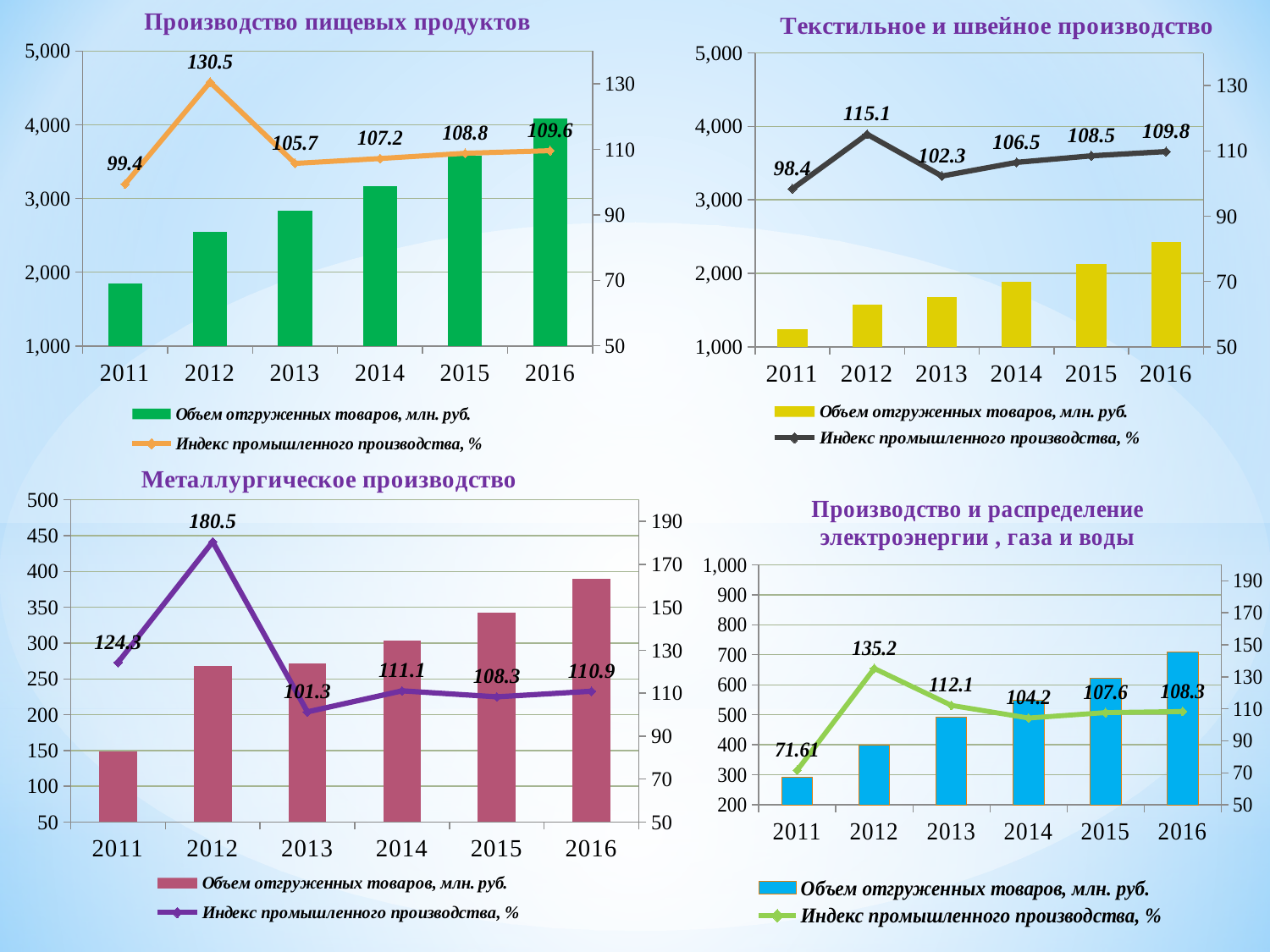
In the chart 'Текстильное и швейное производство', what is the industrial production index for 2014? 106.5 In the chart 'Производство и распределение электроэнергии, газа и воды', how many series does the legend list? 2 In the chart 'Металлургическое производство', which is larger: the industrial production index for 2014 or for 2015? 2014 In the chart 'Производство пищевых продуктов', which year has the lowest industrial production index? 2011 In the chart 'Текстильное и швейное производство', is the volume of shipped goods for 2015 greater or less than 2,000? greater In the chart 'Производство пищевых продуктов', is the volume of shipped goods for 2016 greater or less than 4,000? greater In the chart 'Производство и распределение электроэнергии, газа и воды', how many years are shown on the x axis? 6 In the chart 'Текстильное и швейное производство', what is the difference between the industrial production index in 2012 and in 2011? 16.7 In the chart 'Производство и распределение электроэнергии, газа и воды', what is the industrial production index for 2011? 71.61 In the chart 'Металлургическое производство', which year has the highest industrial production index? 2012 In the chart 'Производство пищевых продуктов', what is the value of the industrial production index for 2012? 130.5 In the chart 'Металлургическое производство', is the volume of shipped goods for 2011 greater or less than 200? less